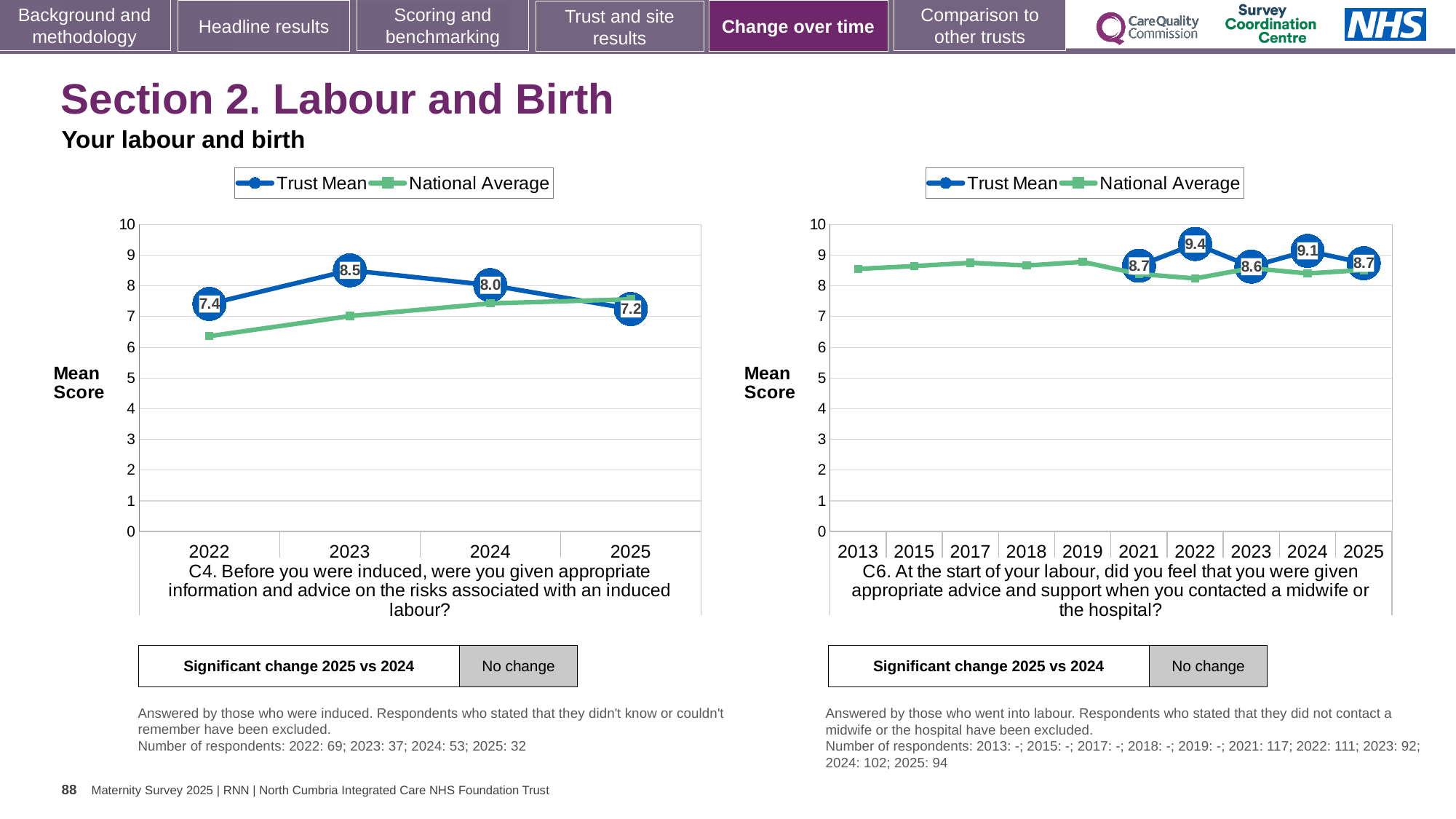
In the C6 chart on the right, which year has the highest Trust Mean? 2022 In the C4 chart on the left, what is the difference between the Trust Mean for 2023 and 2022? 1.1 In the C4 chart on the left, what is the Trust Mean for 2025? 7.2 In the C6 chart on the right, how many years are shown on the x axis? 10 In the C6 chart on the right, what is the Trust Mean for 2022? 9.4 In the C6 chart on the right, how many series does the legend list? 2 In the C4 chart on the left, what is the Trust Mean for 2023? 8.5 In the C4 chart on the left, is the National Average for 2022 greater or less than 7? less In the C4 chart on the left, which year has the lowest Trust Mean? 2025 What type of chart is the C4 chart on the left? Line chart In the C4 chart on the left, which year has the highest Trust Mean? 2023 In the C6 chart on the right, what is the Trust Mean for 2024? 9.1